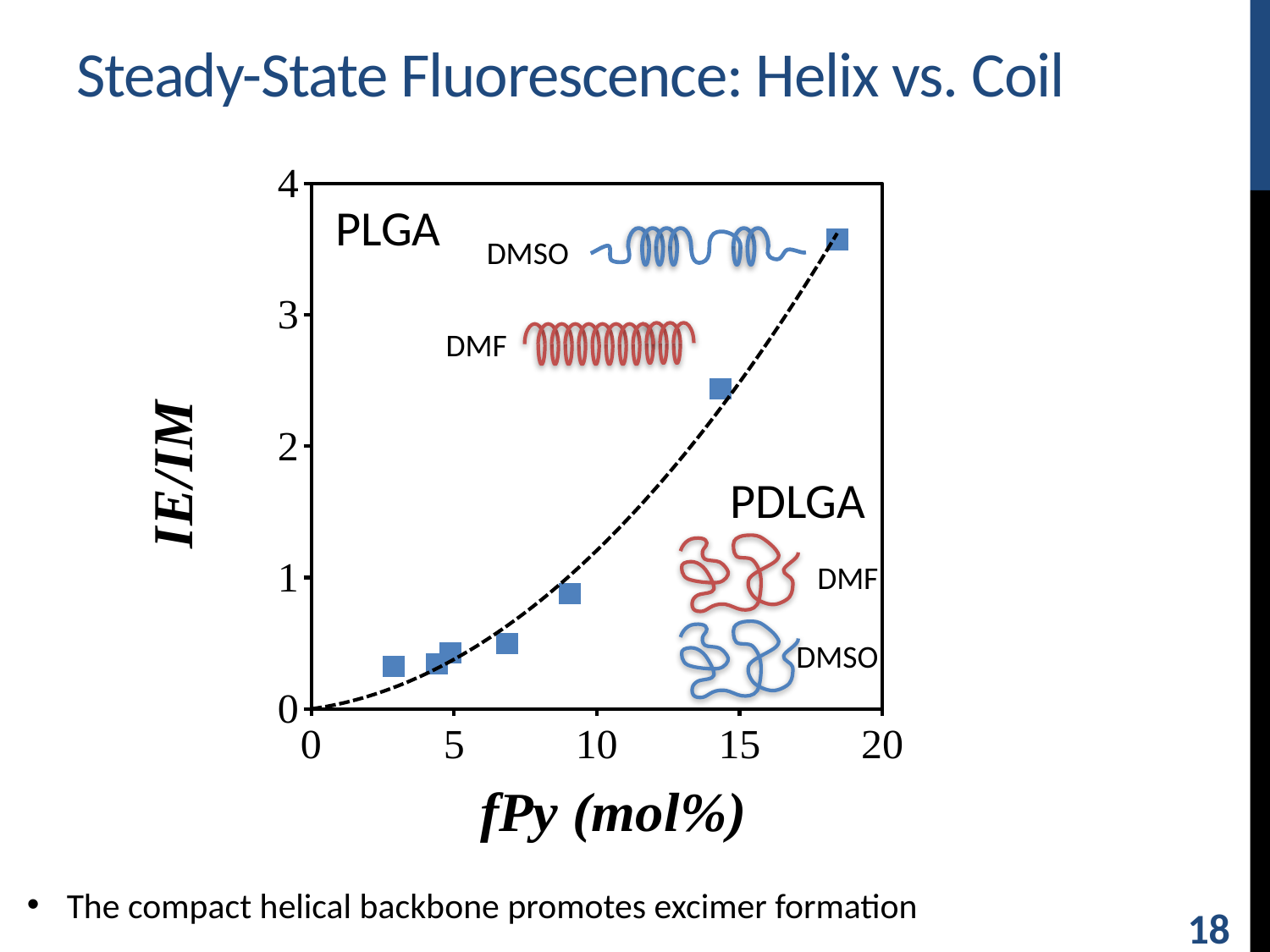
Do the IE/IM values rise or fall as fPy (mol%) increases along the x axis? rise Which data point has the larger IE/IM value: the one near fPy = 9 mol% or the one near fPy = 14 mol%? the one near fPy = 14 mol% Which data point has the highest IE/IM value: the leftmost point or the rightmost point? the rightmost point What is the label on the x axis of the chart? fPy (mol%) What is the label on the y axis of the chart? IE/IM Is the IE/IM value of the rightmost data point (near fPy = 18 mol%) greater or less than 3? greater What kind of chart is shown on the slide? scatter chart Is the IE/IM value of the leftmost data point (near fPy = 3 mol%) greater or less than 1? less Is the IE/IM value of the data point near fPy = 14 mol% greater or less than 2? greater How many data points are plotted on the chart? 7